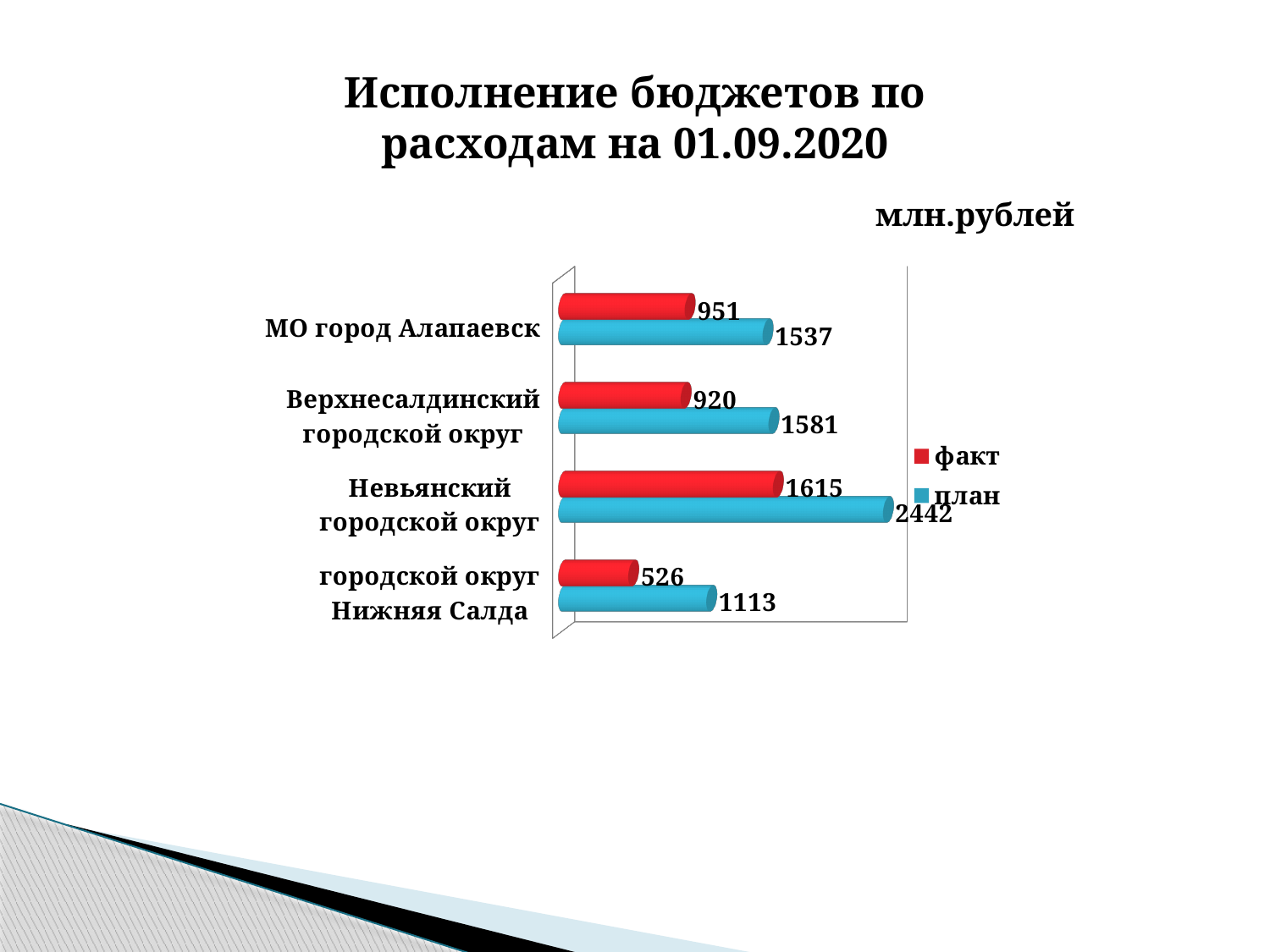
What kind of chart is shown on the slide? bar chart Which category has the lowest факт value? городской округ Нижняя Салда Which category has the highest план value? Невьянский городской округ What is the план value for Невьянский городской округ? 2442 How many categories are shown in the chart? 4 What is the difference between the план and факт values for Невьянский городской округ? 827 What is the факт value for МО город Алапаевск? 951 How many series does the legend list? 2 What is the факт value for Верхнесалдинский городской округ? 920 What unit is stated for the values in the chart? млн.рублей What is the план value for городской округ Нижняя Салда? 1113 Which is larger: the план value for МО город Алапаевск or the план value for Верхнесалдинский городской округ? Верхнесалдинский городской округ